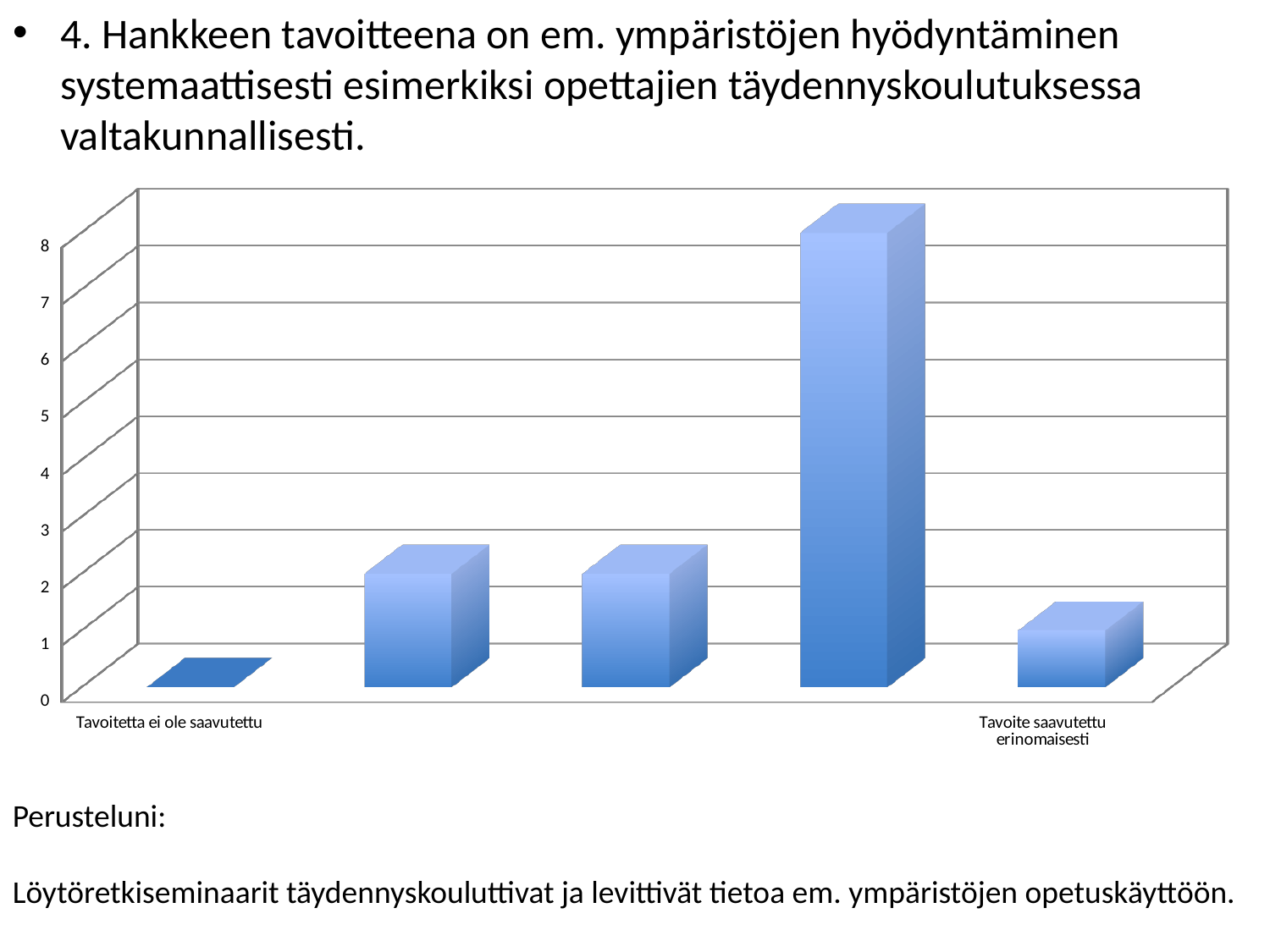
What kind of chart is shown on the slide? Bar chart How many bars does the chart contain? 5 Which category has the lowest value in the chart? Tavoitetta ei ole saavutettu Is the value of the tallest bar greater or less than 6? greater What colour are the bars in the chart? Blue How many bars have a value greater than 5? 1 Is the value for 'Tavoite saavutettu erinomaisesti' greater or less than 2? less Is the value of the second bar from the left greater or less than 4? less What is the highest value shown on the vertical axis? 8 What is the value for the category 'Tavoitetta ei ole saavutettu'? 0 Which of the two labelled categories, 'Tavoitetta ei ole saavutettu' or 'Tavoite saavutettu erinomaisesti', has the larger value? Tavoite saavutettu erinomaisesti Is the tallest bar the one labelled 'Tavoite saavutettu erinomaisesti'? No